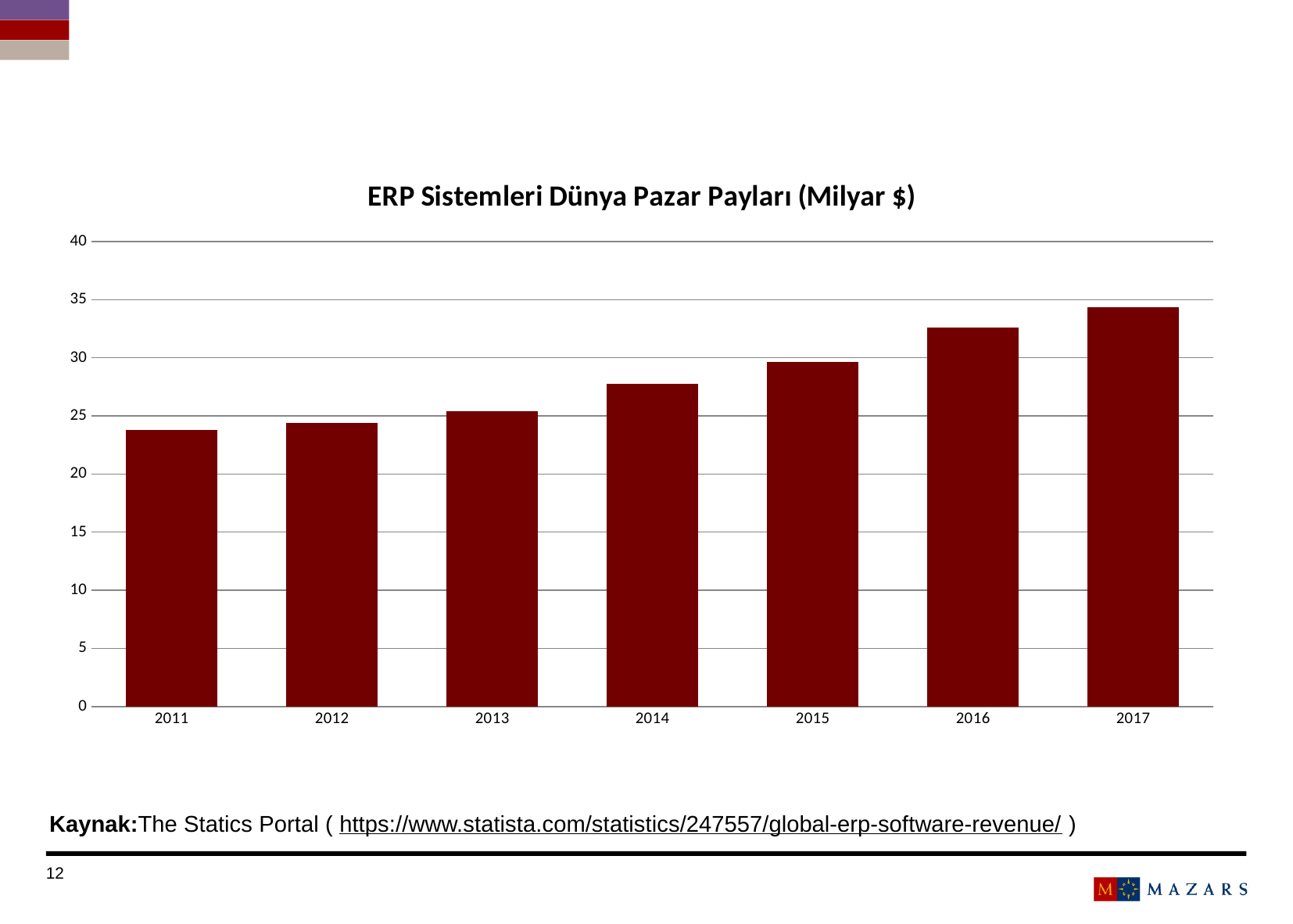
Is the value for 2011 greater or less than 25? less Do the values rise or fall from 2011 to 2017? rise How many years are shown on the x axis of the chart? 7 Is the value for 2014 greater or less than 30? less Which year has the highest value in the chart? 2017 Is the value for 2017 greater or less than 30? greater Which is larger, the value for 2016 or the value for 2012? 2016 Which year has the lowest value in the chart? 2011 What colour are the bars in the chart? dark red What type of chart is shown on the slide? bar chart What is the title of the chart? ERP Sistemleri Dünya Pazar Payları (Milyar $)